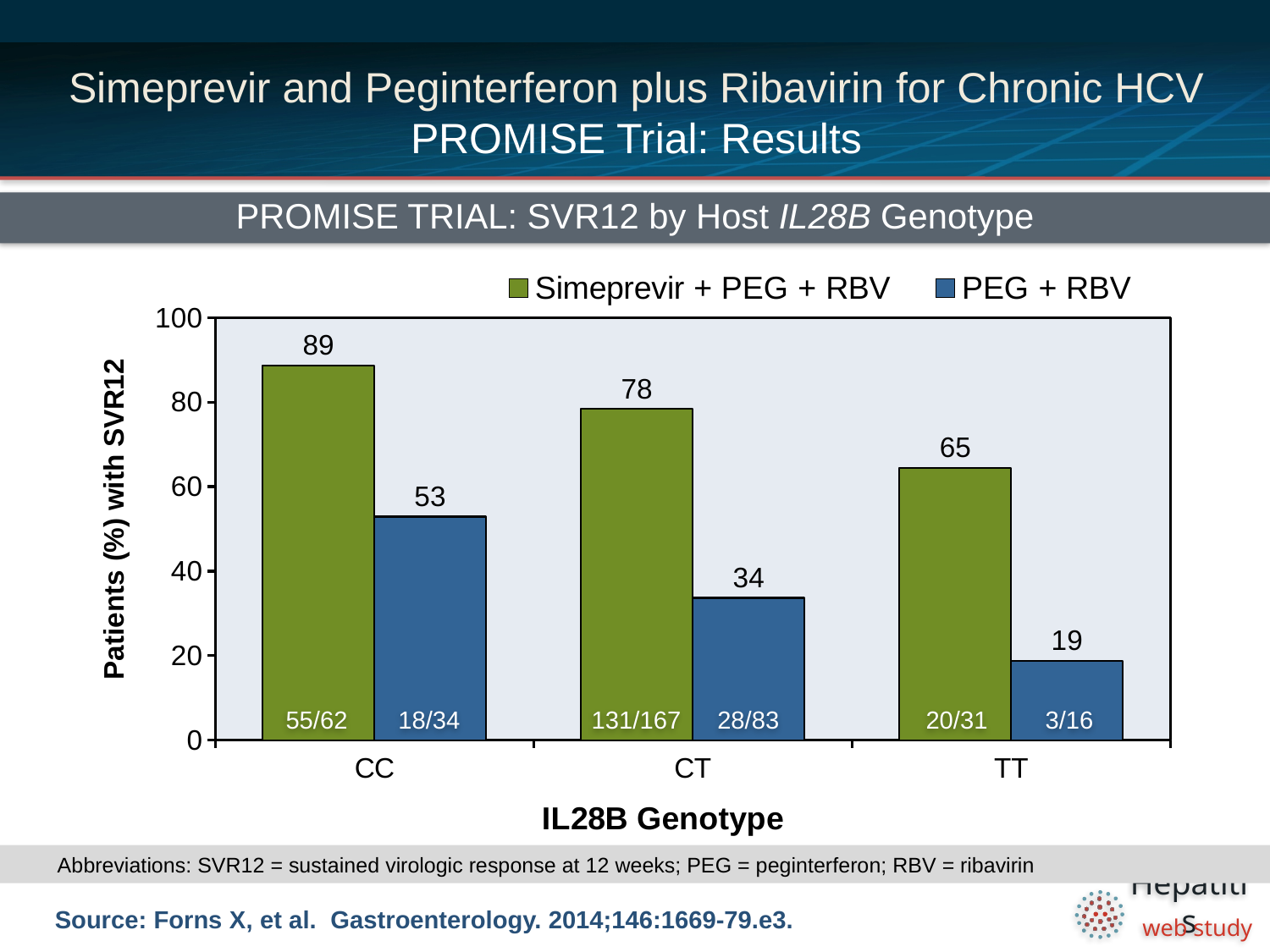
How many genotype categories are shown on the x axis? 3 Which genotype has the lowest SVR12 rate for PEG + RBV? TT What is the SVR12 rate for PEG + RBV in the TT genotype group? 19 What is the difference between the Simeprevir + PEG + RBV SVR12 rates for CC and CT genotypes? 11 What is the SVR12 rate for Simeprevir + PEG + RBV in the CC genotype group? 89 What is the difference between the Simeprevir + PEG + RBV and PEG + RBV SVR12 rates in the TT genotype group? 46 Which is larger: the PEG + RBV SVR12 rate for CC or the Simeprevir + PEG + RBV SVR12 rate for TT? Simeprevir + PEG + RBV for TT How many patients are represented by the Simeprevir + PEG + RBV bar for the CT genotype? 131/167 How many series does the legend list? 2 Which genotype has the highest SVR12 rate for Simeprevir + PEG + RBV? CC What kind of chart is shown on the slide? Bar chart What is the SVR12 rate for PEG + RBV in the CT genotype group? 34